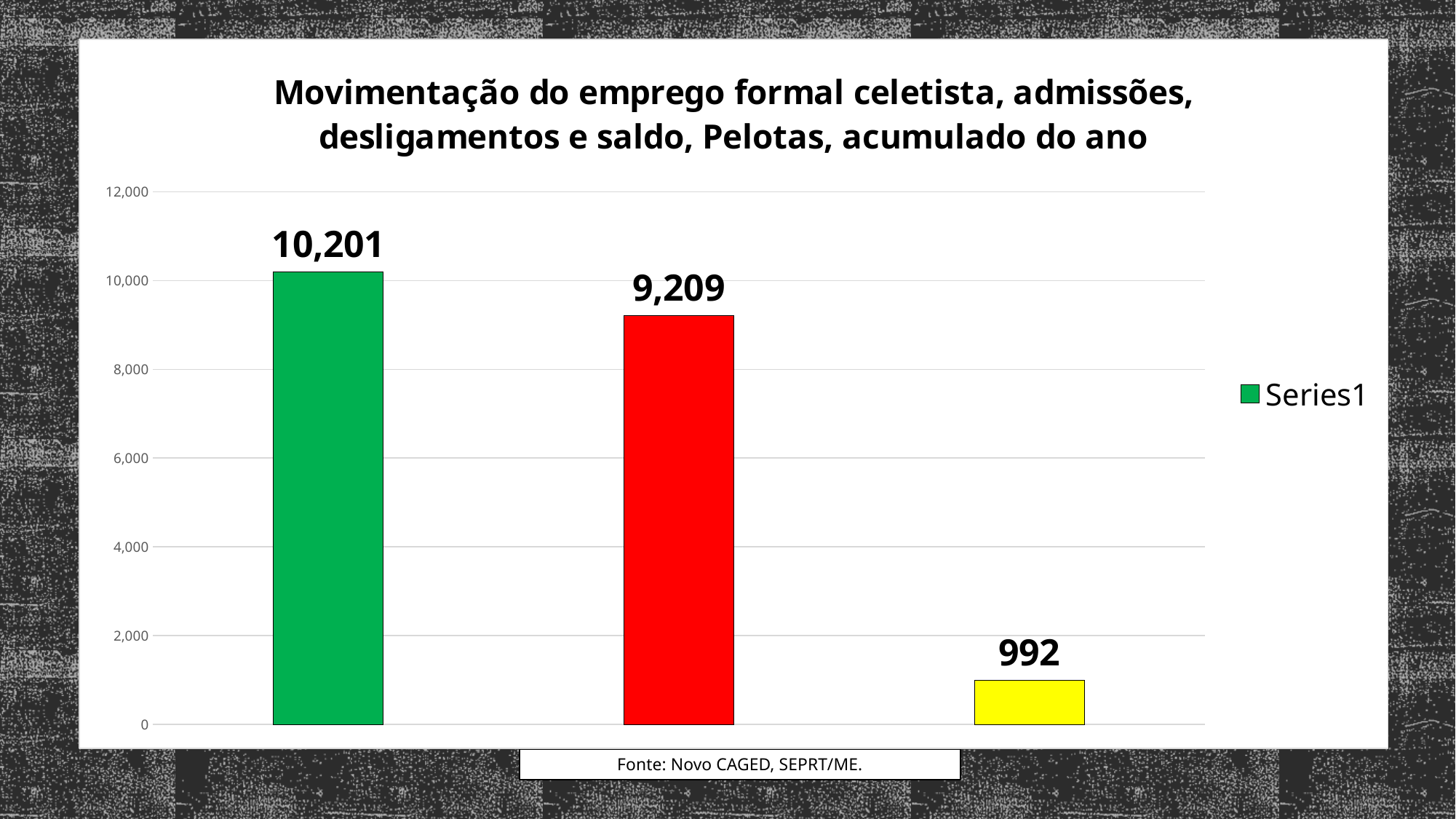
What is the difference between the green bar and the red bar? 992 What is the value of the green bar on the left? 10,201 How many bars are plotted in the chart? 3 What is the value of the red bar in the middle? 9,209 Which is larger, the red bar or the yellow bar? The red bar Which bar has the lowest value? The yellow bar on the right (992) What type of chart is shown on the slide? Bar chart Which bar has the highest value? The green bar on the left (10,201) What is the difference between the red bar and the yellow bar? 8,217 How many series does the legend list? 1 Is the value of the green bar greater or less than 10,000? greater What is the value of the yellow bar on the right? 992